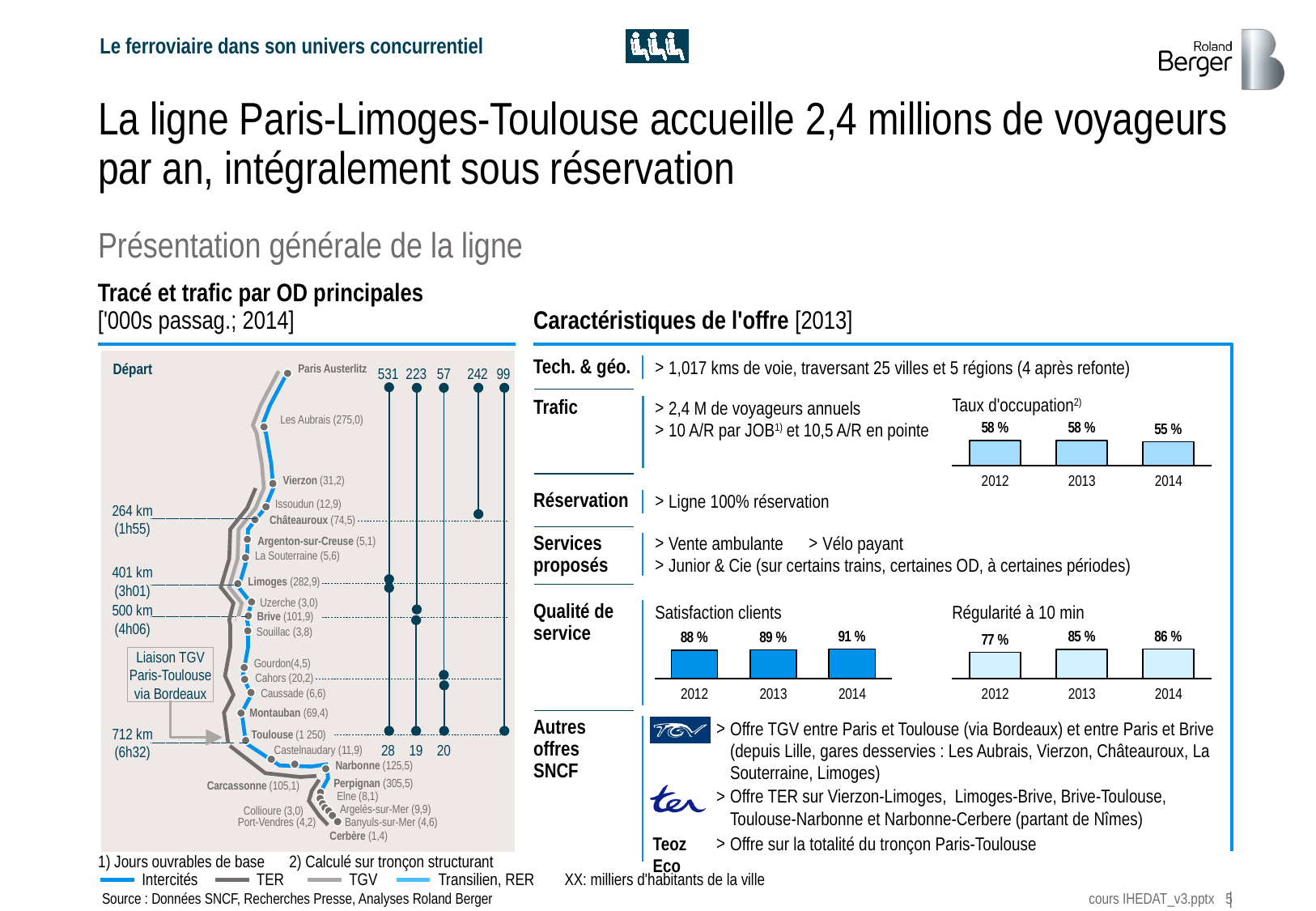
In the Régularité à 10 min chart, do the values rise or fall from 2012 to 2014? rise In the Taux d'occupation chart, what is the value for 2014? 55 % In the Satisfaction clients chart, what is the value for 2014? 91 % In the Régularité à 10 min chart, which year has the highest value? 2014 In the Régularité à 10 min chart, what is the difference between the 2013 and 2012 values? 8 % In the Satisfaction clients chart, which year has the lowest value? 2012 What kind of chart is the Satisfaction clients chart? bar chart In the Régularité à 10 min chart, what is the value for 2012? 77 % In the Satisfaction clients chart, what is the difference between the 2014 and 2012 values? 3 % In the Taux d'occupation chart, what is the value for 2012? 58 % In the Taux d'occupation chart, is the value for 2013 larger or smaller than the value for 2014? larger In the Taux d'occupation chart, how many years are shown? 3